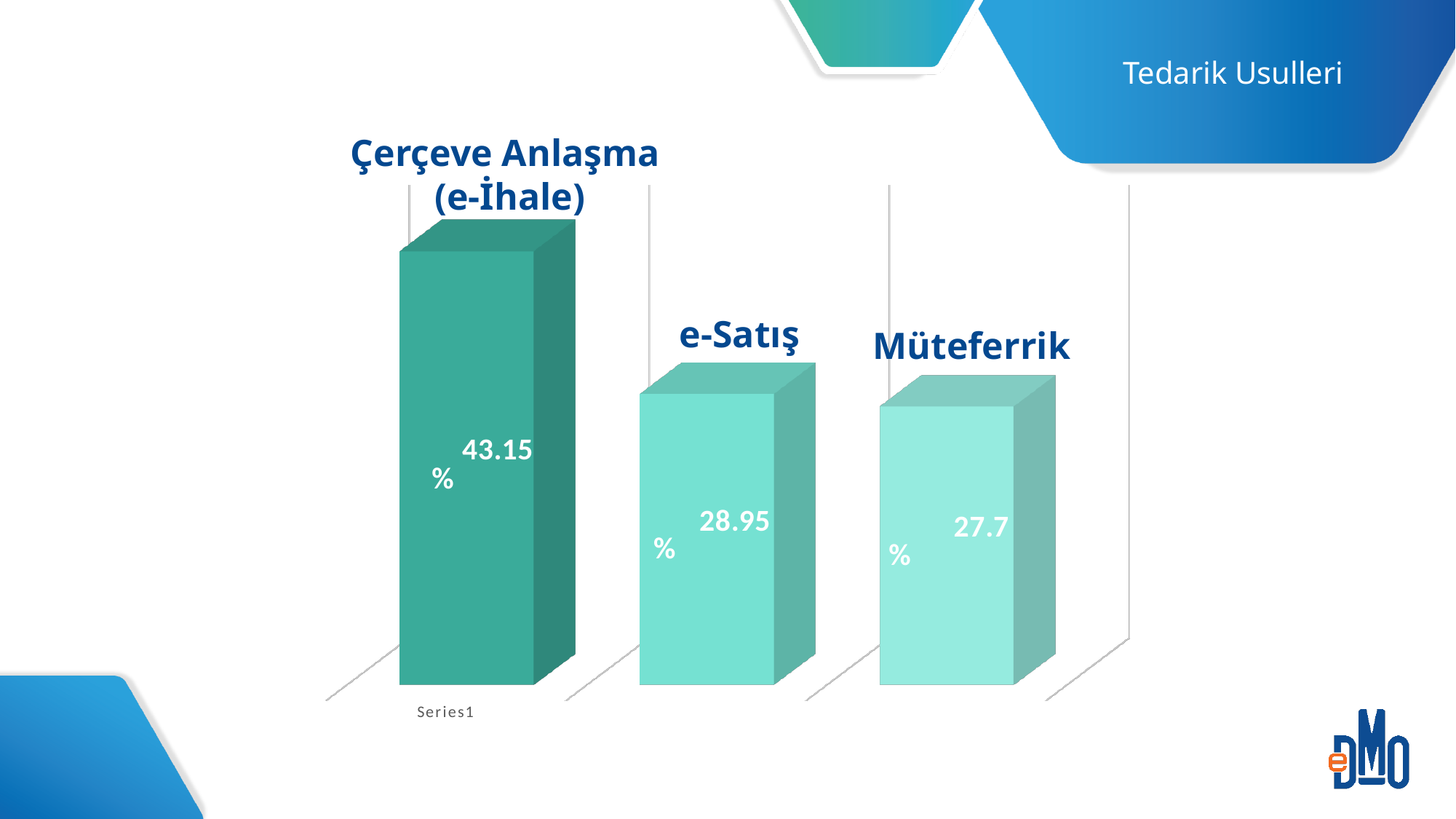
What is the difference between the values for e-Satış and Müteferrik? 1.25 percentage points Do the values rise or fall from left to right across the categories? Fall Which is larger, the value for e-Satış or the value for Müteferrik? e-Satış What is the value for Çerçeve Anlaşma (e-İhale)? %43.15 Which category has the highest value? Çerçeve Anlaşma (e-İhale) Which category has the lowest value? Müteferrik What is the difference between the values for Çerçeve Anlaşma (e-İhale) and e-Satış? 14.2 percentage points What is the title shown in the top-right corner of the slide? Tedarik Usulleri How many categories are shown in the chart? 3 What is the value for Müteferrik? %27.7 What kind of chart is shown on the slide? Bar chart What is the value for e-Satış? %28.95